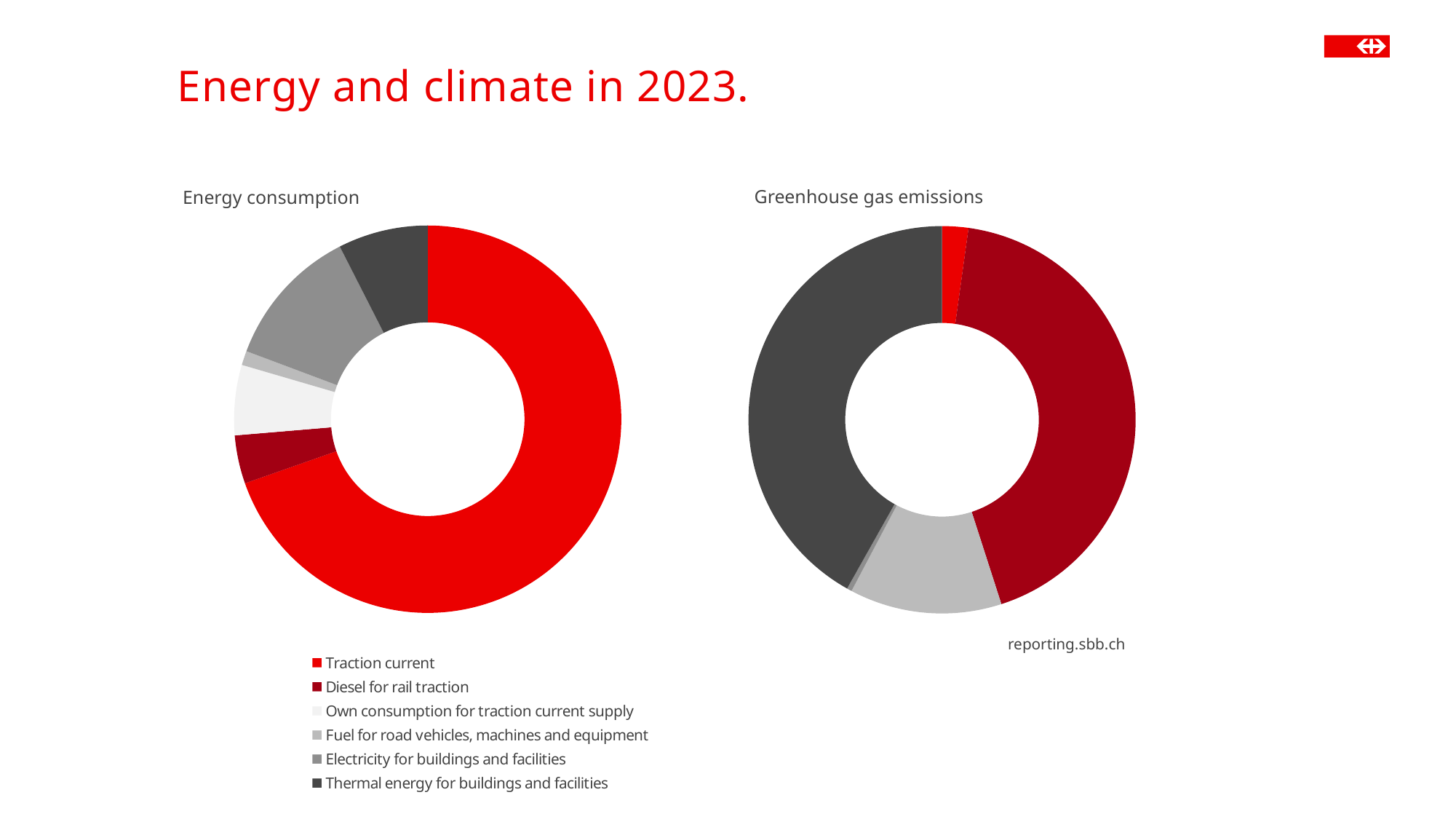
In the Greenhouse gas emissions chart, which is larger: Thermal energy for buildings and facilities or Traction current? Thermal energy for buildings and facilities What kind of chart is the Energy consumption chart? Pie chart (donut) How many categories does the legend list for the charts? 6 In the Energy consumption chart, which is larger: Electricity for buildings and facilities or Diesel for rail traction? Electricity for buildings and facilities How many entries are in the shared legend? 6 In the Greenhouse gas emissions chart, which is larger: Diesel for rail traction or Fuel for road vehicles, machines and equipment? Diesel for rail traction In the Energy consumption chart, which category has the smallest share? Fuel for road vehicles, machines and equipment What is the title of the chart on the right? Greenhouse gas emissions Which legend entry is shown in bright red? Traction current In the Energy consumption chart, which category has the largest share? Traction current What kind of chart is the Greenhouse gas emissions chart? Pie chart (donut)